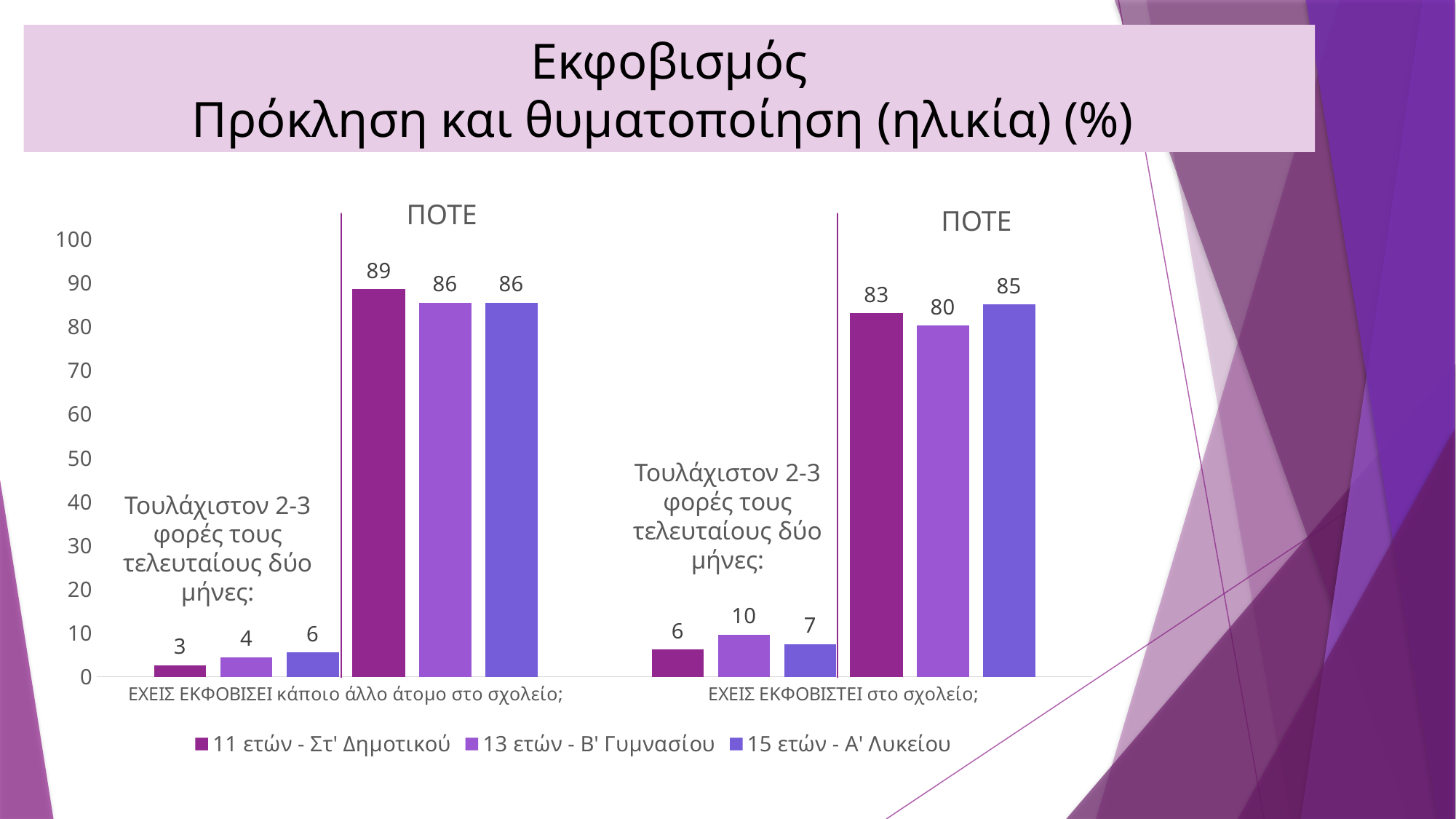
Which age group has the highest ΠΟΤΕ value for 'ΕΧΕΙΣ ΕΚΦΟΒΙΣΤΕΙ στο σχολείο;'? 15 ετών - Α' Λυκείου Is the ΠΟΤΕ value for 11 ετών - Στ' Δημοτικού for 'ΕΧΕΙΣ ΕΚΦΟΒΙΣΕΙ κάποιο άλλο άτομο στο σχολείο;' greater or less than 80? greater What kind of chart is shown on the slide? bar chart What is the difference between the ΠΟΤΕ values for 11 ετών and 13 ετών for 'ΕΧΕΙΣ ΕΚΦΟΒΙΣΤΕΙ στο σχολείο;'? 3 In the 'Τουλάχιστον 2-3 φορές' group for 'ΕΧΕΙΣ ΕΚΦΟΒΙΣΤΕΙ στο σχολείο;', which is larger: the value for 13 ετών or for 15 ετών? 13 ετών - Β' Γυμνασίου Which age group has the lowest value in the 'Τουλάχιστον 2-3 φορές' group for 'ΕΧΕΙΣ ΕΚΦΟΒΙΣΕΙ κάποιο άλλο άτομο στο σχολείο;'? 11 ετών - Στ' Δημοτικού What is the value for 11 ετών - Στ' Δημοτικού in the ΠΟΤΕ group for 'ΕΧΕΙΣ ΕΚΦΟΒΙΣΕΙ κάποιο άλλο άτομο στο σχολείο;'? 89 What is the title of the chart on the slide? Εκφοβισμός Πρόκληση και θυματοποίηση (ηλικία) (%) What is the value for 13 ετών - Β' Γυμνασίου in the 'Τουλάχιστον 2-3 φορές τους τελευταίους δύο μήνες' group for 'ΕΧΕΙΣ ΕΚΦΟΒΙΣΤΕΙ στο σχολείο;'? 10 What is the value for 15 ετών - Α' Λυκείου in the 'Τουλάχιστον 2-3 φορές τους τελευταίους δύο μήνες' group for 'ΕΧΕΙΣ ΕΚΦΟΒΙΣΕΙ κάποιο άλλο άτομο στο σχολείο;'? 6 How many series does the legend list? 3 What is the value for 13 ετών - Β' Γυμνασίου in the ΠΟΤΕ group for 'ΕΧΕΙΣ ΕΚΦΟΒΙΣΤΕΙ στο σχολείο;'? 80